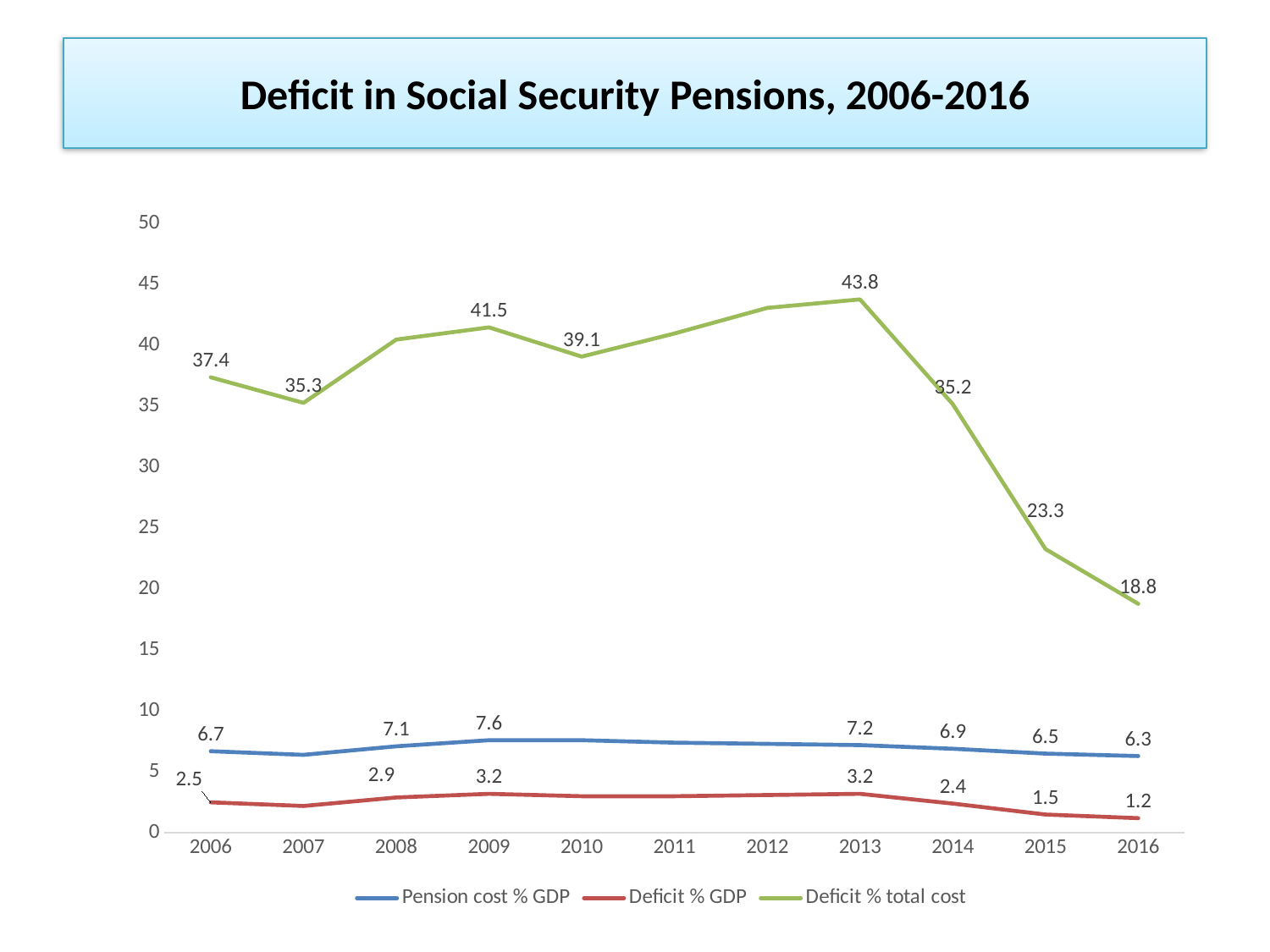
Does Deficit % total cost rise or fall from 2013 to 2016? fall Is the value of Deficit % total cost in 2012 greater or less than 40? greater What is the difference between Deficit % total cost in 2013 and in 2016? 25 What is the value of Deficit % GDP in 2016? 1.2 What is the value of Deficit % total cost in 2013? 43.8 What type of chart is shown on the slide? line chart How many years are plotted along the x axis? 11 Which is larger, Deficit % total cost in 2006 or in 2007? 2006 How many series does the legend list? 3 In which year is Deficit % total cost at its lowest? 2016 In which year is Deficit % total cost at its highest? 2013 What is the value of Pension cost % GDP in 2009? 7.6